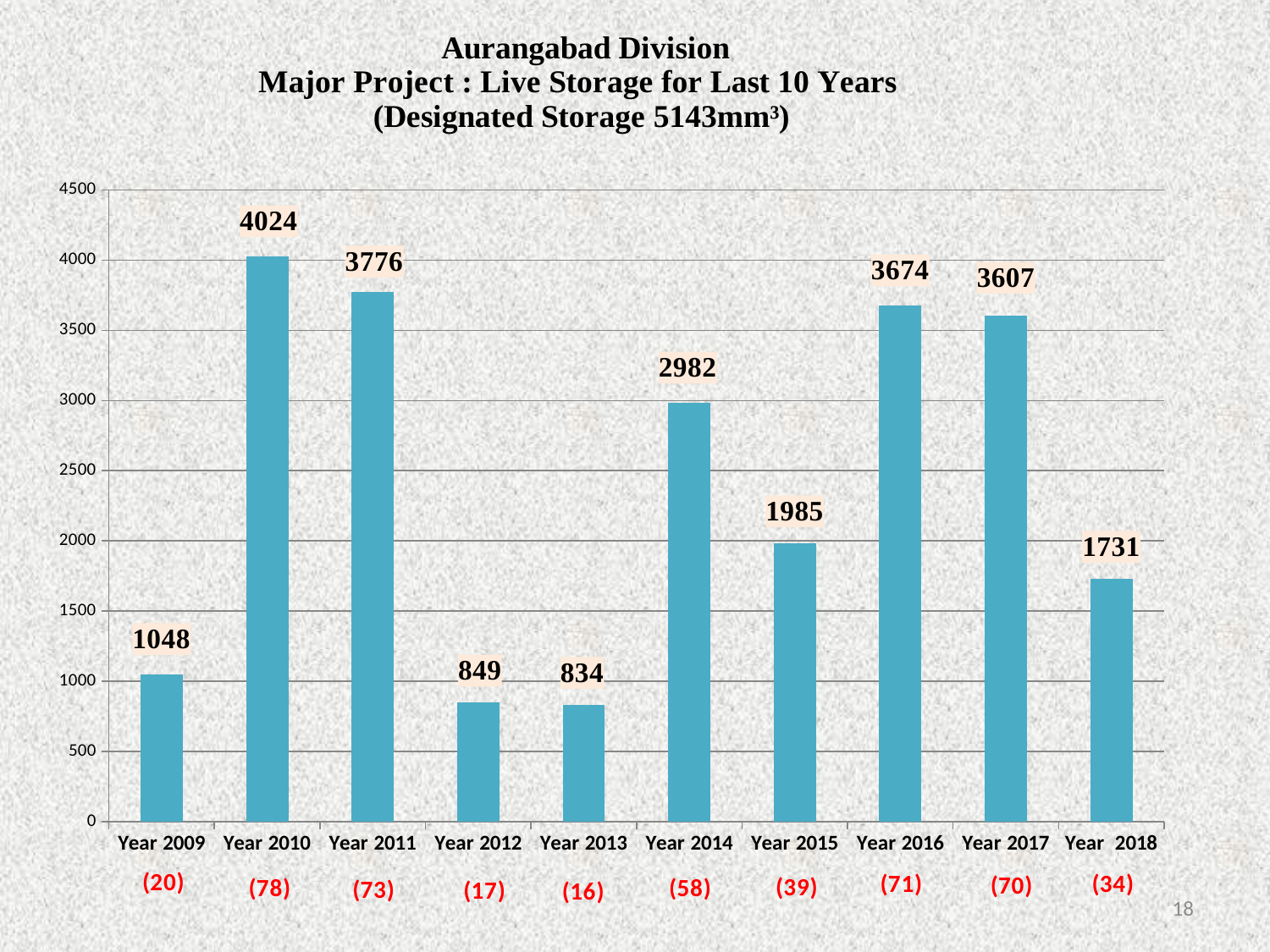
How many years are shown on the chart? 10 What is the live storage value for Year 2018? 1731 What kind of chart is shown on the slide? bar chart Is the value for Year 2009 greater or less than 1500? less What is the live storage value for Year 2013? 834 What is the difference between the live storage values for Year 2010 and Year 2011? 248 Which year has the highest live storage value? Year 2010 What is the live storage value for Year 2010? 4024 Which is larger, the live storage value for Year 2014 or for Year 2015? Year 2014 Which year has the lowest live storage value? Year 2013 What is the designated storage stated in the chart title? 5143mm³ What is the difference between the live storage values for Year 2016 and Year 2017? 67